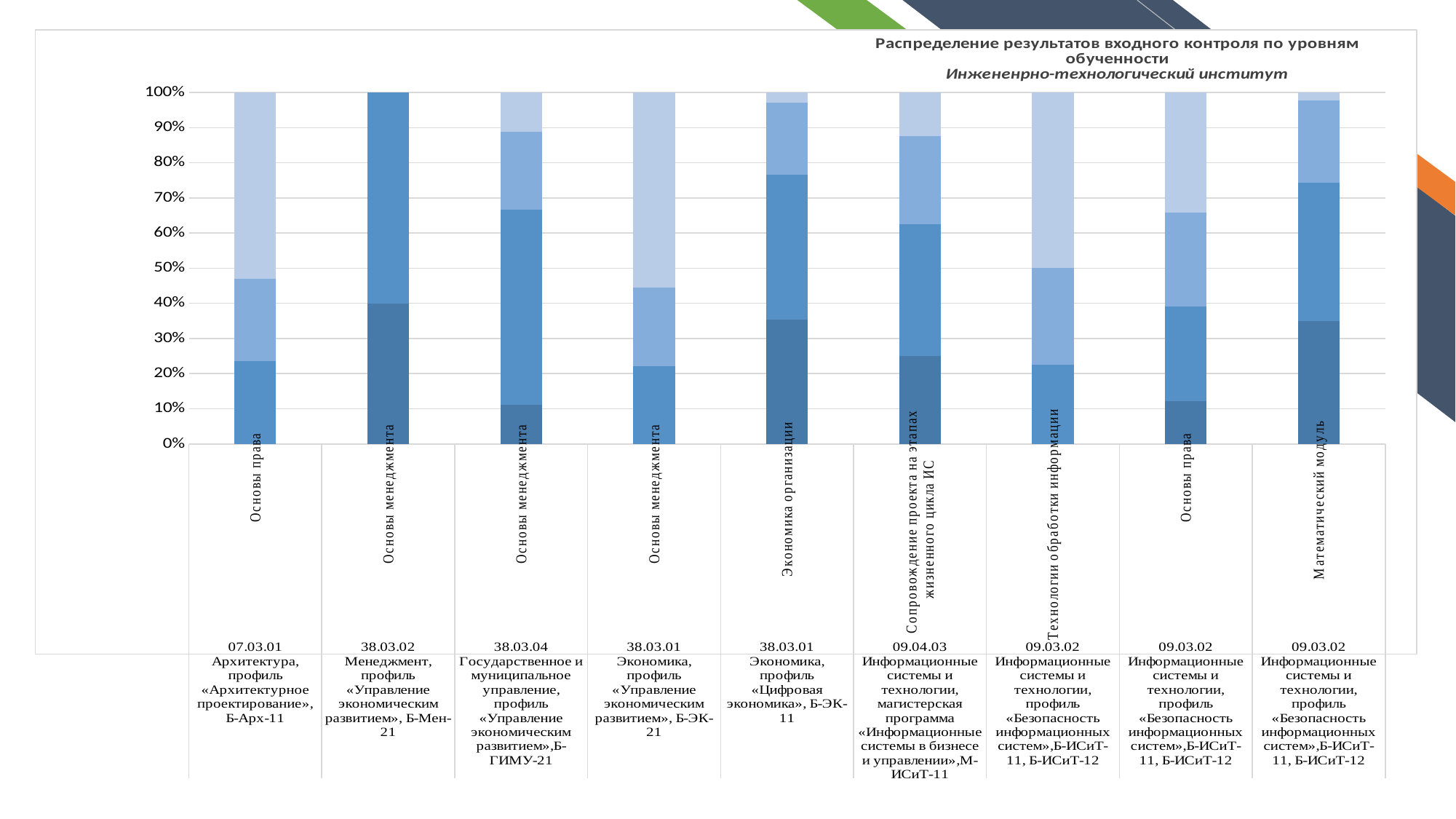
Which bar has the largest bottom (darkest) segment? Основы менеджмента, 38.03.02 Б-Мен-21 Which bar has no light-blue top segment, consisting only of the two darker segments? Основы менеджмента, 38.03.02 Б-Мен-21 What kind of chart is shown on the slide? Stacked bar chart How many bars (programme/discipline categories) are plotted in the chart? 9 Is the top of the middle (medium blue) segment of the bar for Основы права, 07.03.01 Б-Арх-11 greater or less than 60%? less What is the maximum value shown on the vertical axis of the chart? 100% Which bar has a larger bottom (darkest) segment: Основы менеджмента, 38.03.02 Б-Мен-21 or Основы менеджмента, 38.03.04 Б-ГИМУ-21? Основы менеджмента, 38.03.02 Б-Мен-21 What is the title of the chart? Распределение результатов входного контроля по уровням обученности Инжененрно-технологический институт Is the bottom (darkest) segment of the bar for Основы менеджмента, 38.03.04 Б-ГИМУ-21 greater or less than 20%? less Is the bottom (darkest) segment of the bar for Основы менеджмента, 38.03.02 Б-Мен-21 greater or less than 30%? greater